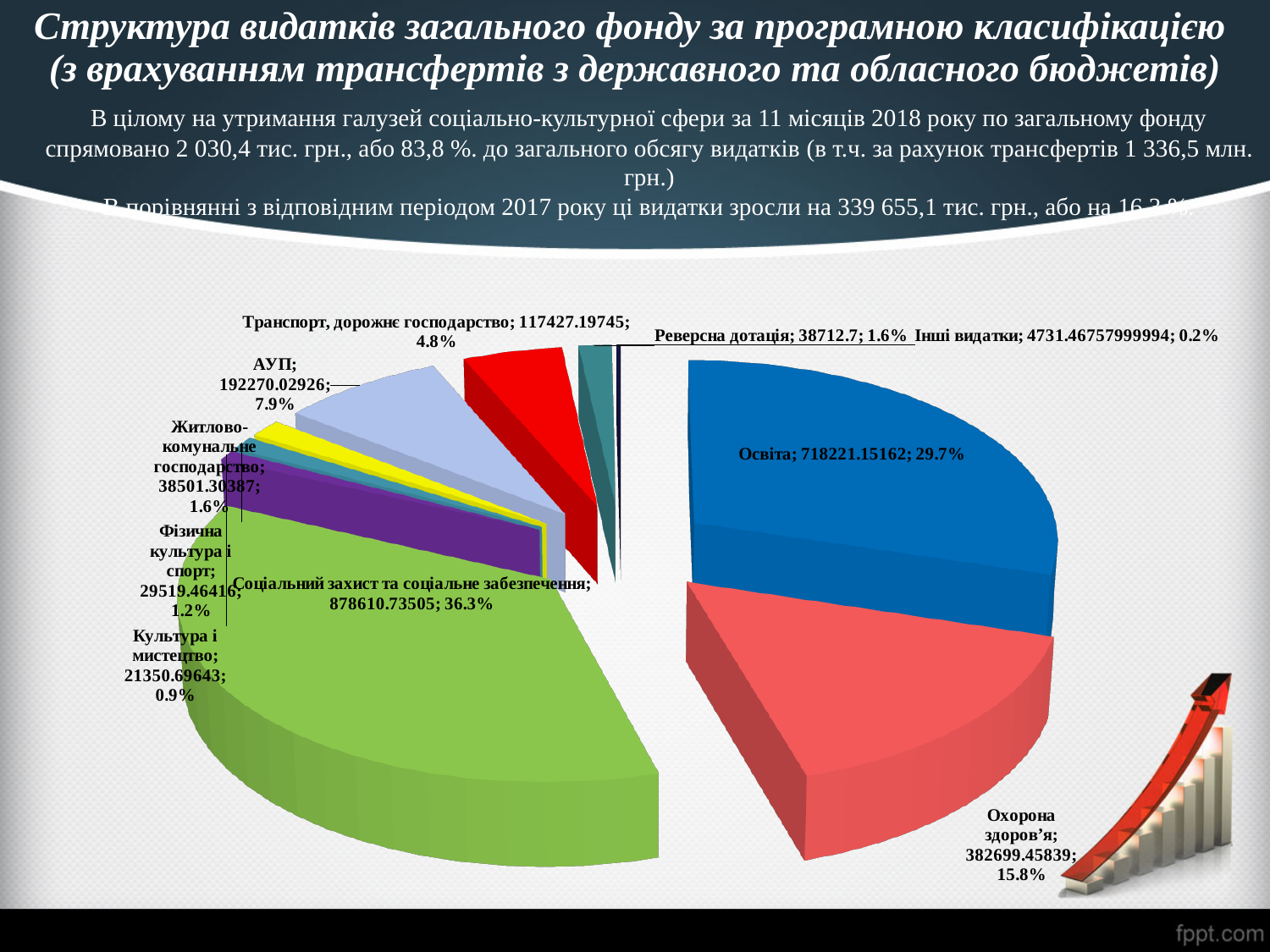
How many slices does the pie chart have? 10 Which category has the smallest slice of the pie? Інші видатки What is the value shown for Охорона здоров’я? 382699.45839 What is the value shown for АУП? 192270.02926 What is the percentage share shown for Культура і мистецтво? 0.9% Which is larger, the value for Освіта or the value for Охорона здоров’я? Освіта What is the value shown for Освіта? 718221.15162 What share of the pie does Соціальний захист та соціальне забезпечення take? 36.3% What share of the pie does Транспорт, дорожнє господарство take? 4.8% Which category has the largest slice of the pie? Соціальний захист та соціальне забезпечення What is the difference in percentage share between Освіта and Охорона здоров’я? 13.9% What kind of chart is shown on the slide? pie chart